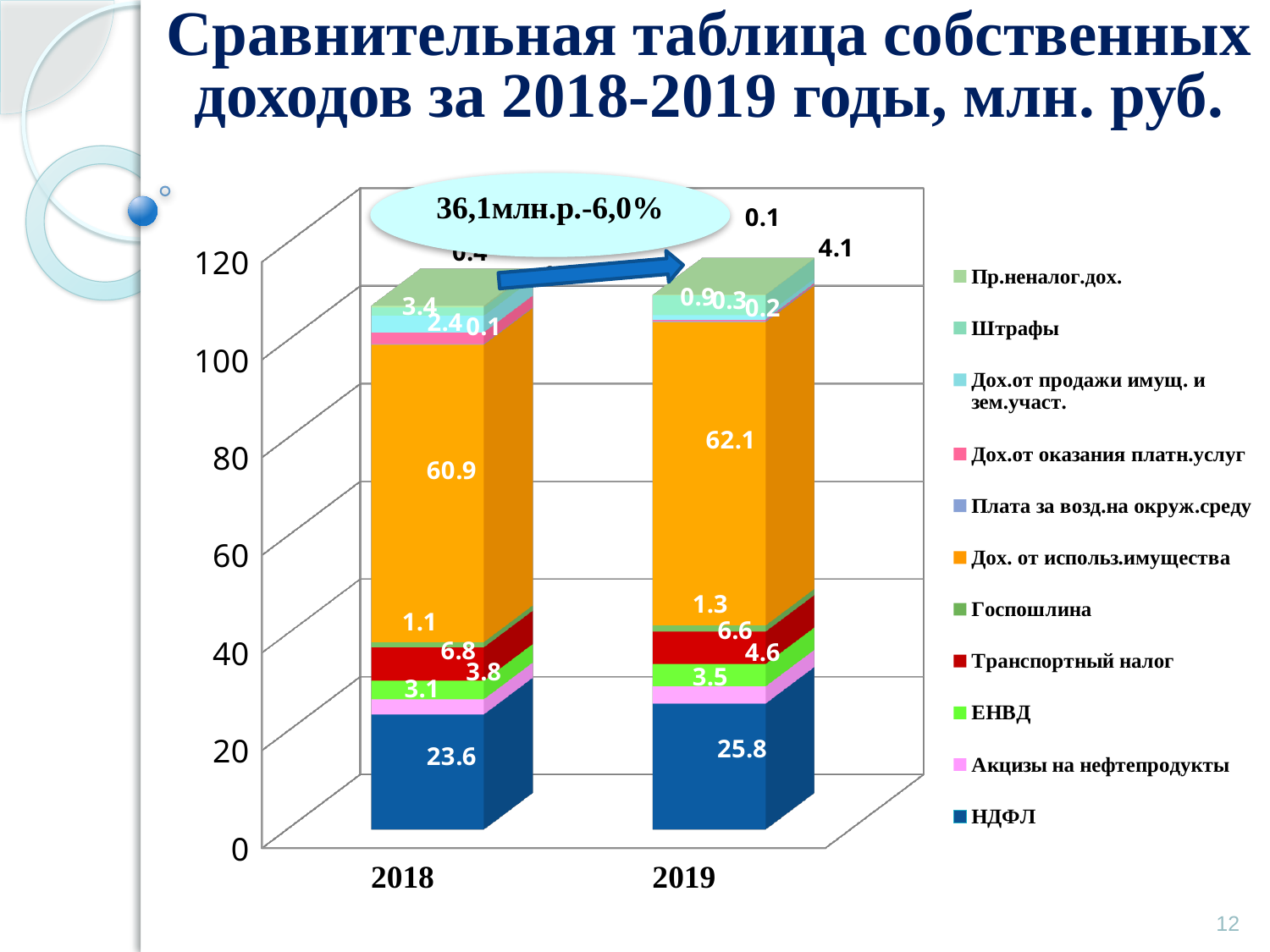
What is the value of Транспортный налог for 2018? 6.8 Which series forms the largest segment of the 2019 bar? Дох. от использ.имущества How many years (categories) are shown on the x axis? 2 What is the value of НДФЛ for 2019? 25.8 What is the value of Госпошлина for 2019? 1.3 How many series does the legend list? 11 What kind of chart is shown on the slide? Stacked bar chart By how much did НДФЛ increase from 2018 to 2019? 2.2 What is the value of Дох. от использ.имущества for 2019? 62.1 What is the value of НДФЛ for 2018? 23.6 Which year has the larger value for Транспортный налог, 2018 or 2019? 2018 What is the difference between Дох. от использ.имущества in 2019 and 2018? 1.2